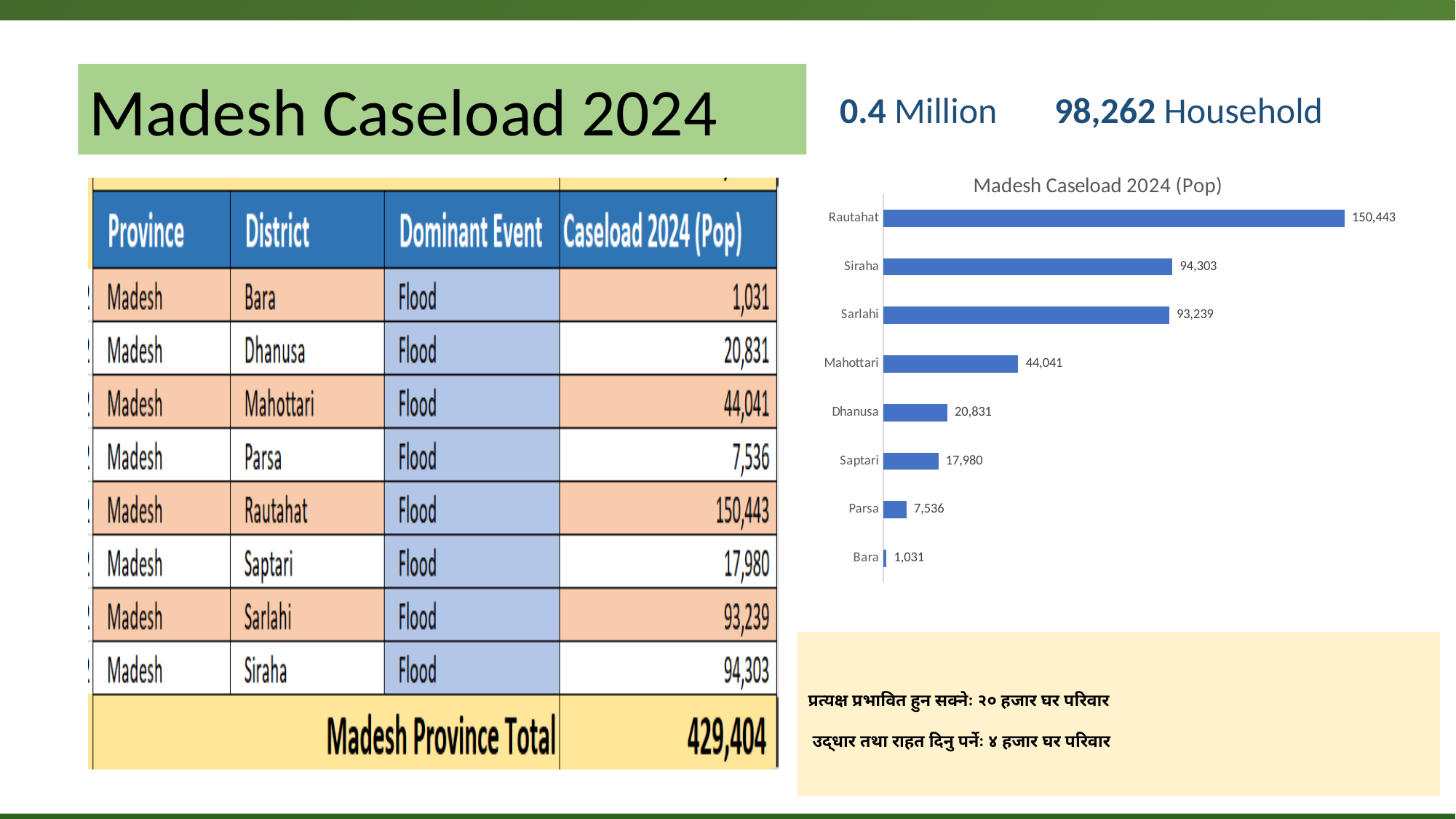
In the Madesh Caseload 2024 (Pop) chart, which is larger, the value for Saptari or the value for Parsa? Saptari What is the value for Mahottari in the Madesh Caseload 2024 (Pop) chart? 44,041 Which district has the highest value in the Madesh Caseload 2024 (Pop) chart? Rautahat How many districts are shown in the Madesh Caseload 2024 (Pop) chart? 8 What kind of chart is the Madesh Caseload 2024 (Pop) chart? Bar chart What is the value for Saptari in the Madesh Caseload 2024 (Pop) chart? 17,980 What is the title of the chart on the slide? Madesh Caseload 2024 (Pop) In the Madesh Caseload 2024 (Pop) chart, which is larger, the value for Mahottari or the value for Dhanusa? Mahottari What is the value for Rautahat in the Madesh Caseload 2024 (Pop) chart? 150,443 Which district has the lowest value in the Madesh Caseload 2024 (Pop) chart? Bara What is the difference between the values for Rautahat and Siraha in the Madesh Caseload 2024 (Pop) chart? 56,140 What is the difference between the values for Dhanusa and Parsa in the Madesh Caseload 2024 (Pop) chart? 13,295